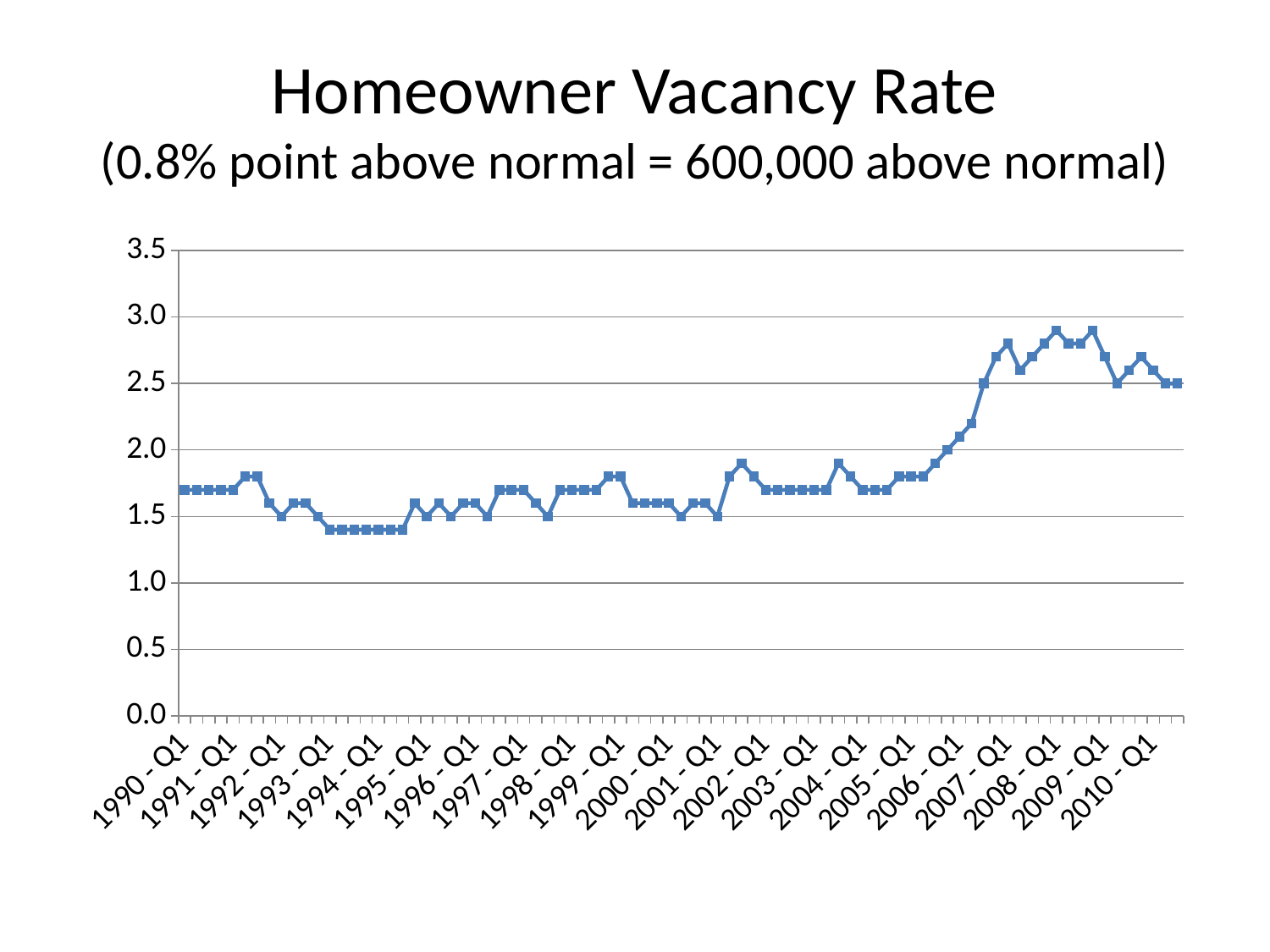
According to the subtitle, 0.8% point above normal corresponds to how many units above normal? 600,000 Is the value for 1994 - Q1 greater or less than 1.5? less What kind of chart is shown on the slide? Line chart Is the value for 2009 - Q1 greater or less than 2.5? greater Is the value for 2008 - Q1 greater or less than 2.5? greater Which is larger, the value for 1994 - Q1 or the value for 2000 - Q1? 2000 - Q1 Does the homeowner vacancy rate rise or fall between 2006 - Q1 and 2008 - Q1? rise Which is larger, the value for 2008 - Q1 or the value for 1990 - Q1? 2008 - Q1 What is the title of the chart on the slide? Homeowner Vacancy Rate